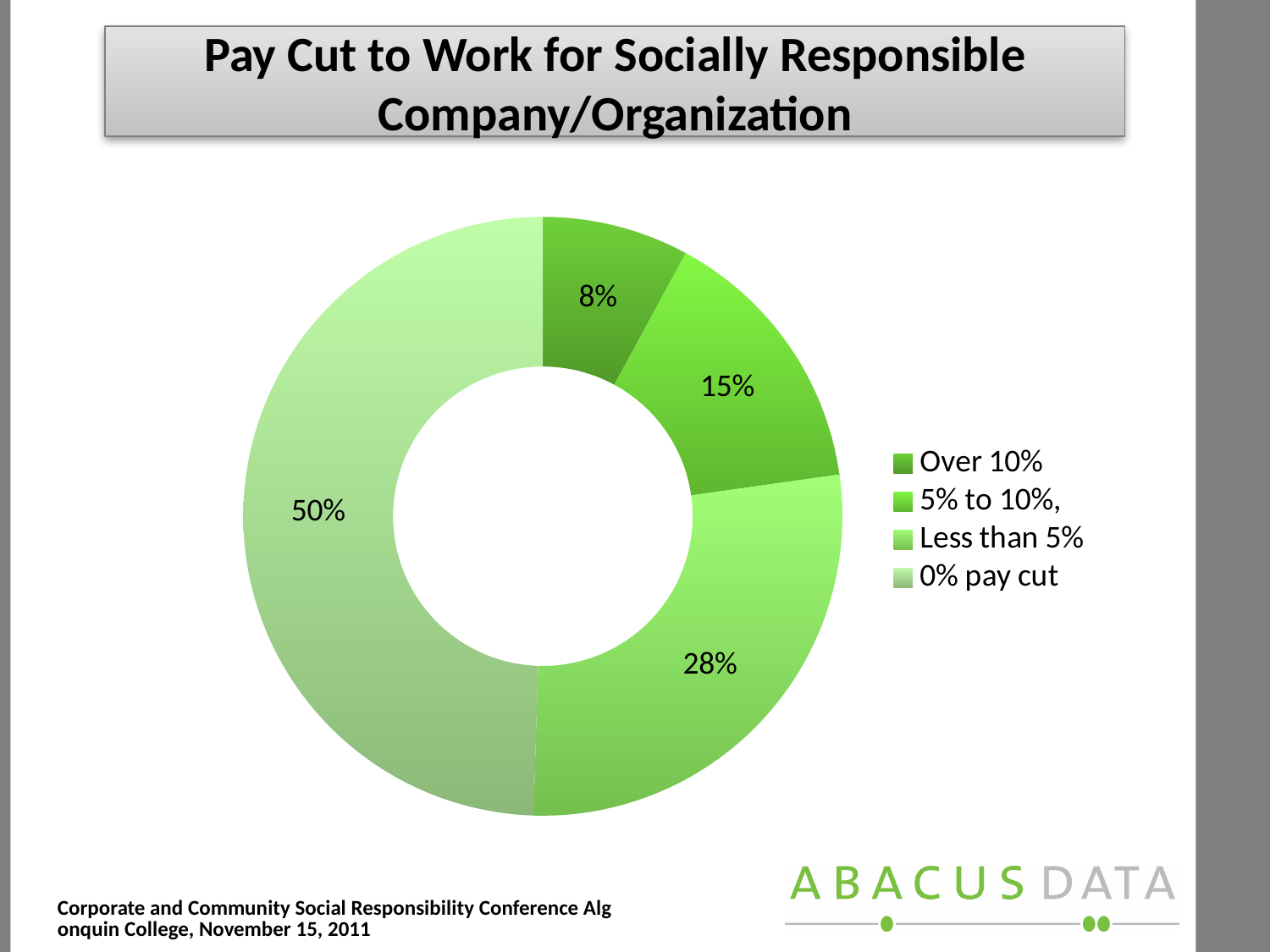
What share of respondents would take a 0% pay cut? 50% Which category has the smallest share of the chart? Over 10% What share of respondents would take a pay cut of over 10%? 8% What is the title of the chart? Pay Cut to Work for Socially Responsible Company/Organization What is the combined share of respondents willing to take any pay cut (Over 10%, 5% to 10%, and Less than 5%)? 51% Which category has the largest share of the chart? 0% pay cut What share of respondents would take a pay cut of 5% to 10%? 15% How many categories does the chart show? 4 Which is larger: the share for '5% to 10%' or the share for 'Over 10%'? 5% to 10% What share of respondents would take a pay cut of less than 5%? 28% What kind of chart is shown on the slide? Pie chart (doughnut) What is the difference between the share for 'Less than 5%' and the share for '5% to 10%'? 13%